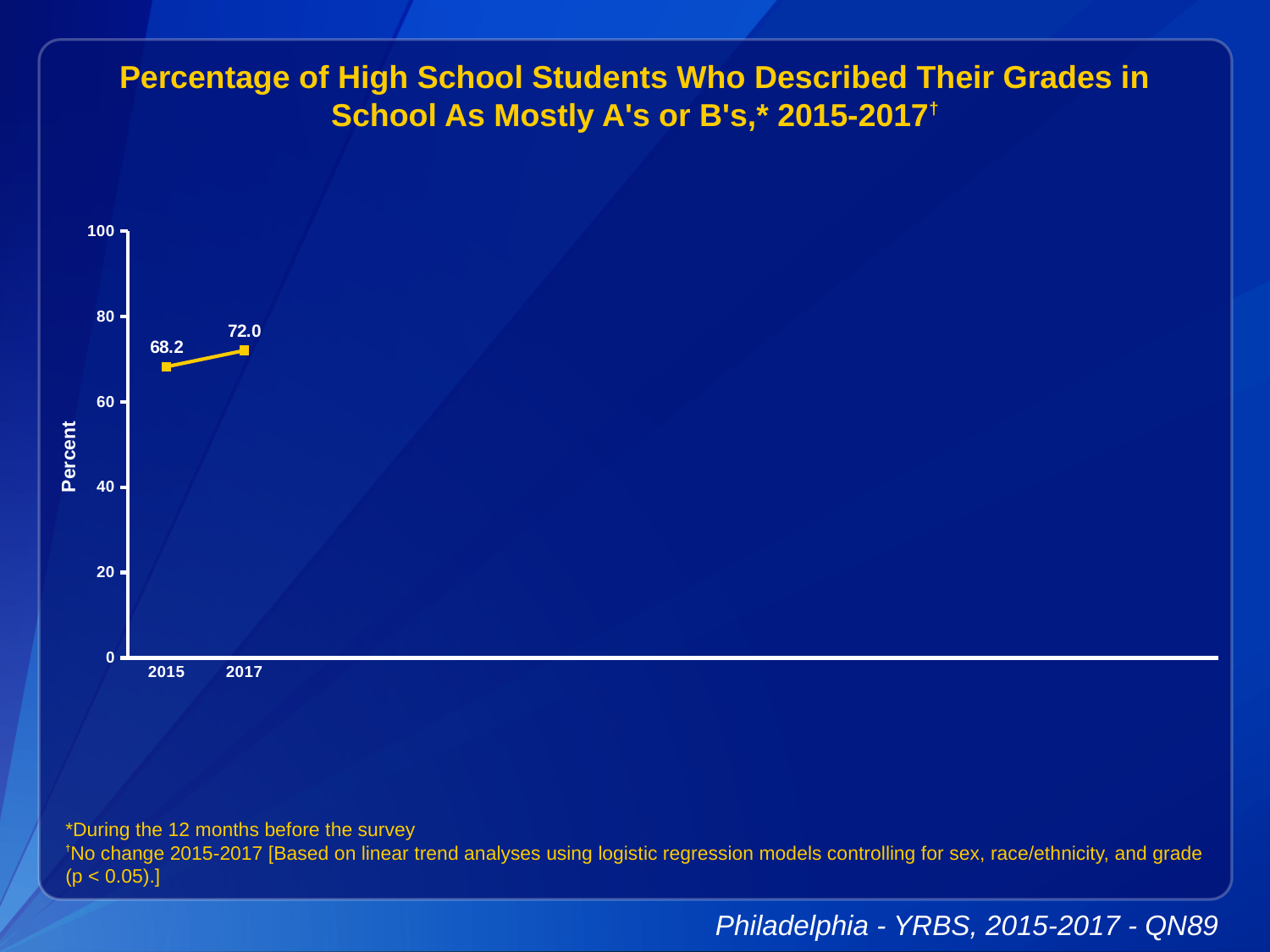
What is the difference between the values for 2017 and 2015? 3.8 Which is larger, the value for 2015 or the value for 2017? 2017 Do the values rise or fall from 2015 to 2017? rise What is the value for 2015? 68.2 Which year has the highest value? 2017 How many data points are plotted on the chart? 2 Which year has the lowest value? 2015 What is the value for 2017? 72.0 Is the value for 2015 greater or less than 60? greater What is the label of the y axis? Percent Is the value for 2017 greater or less than 80? less What kind of chart is shown on the slide? line chart